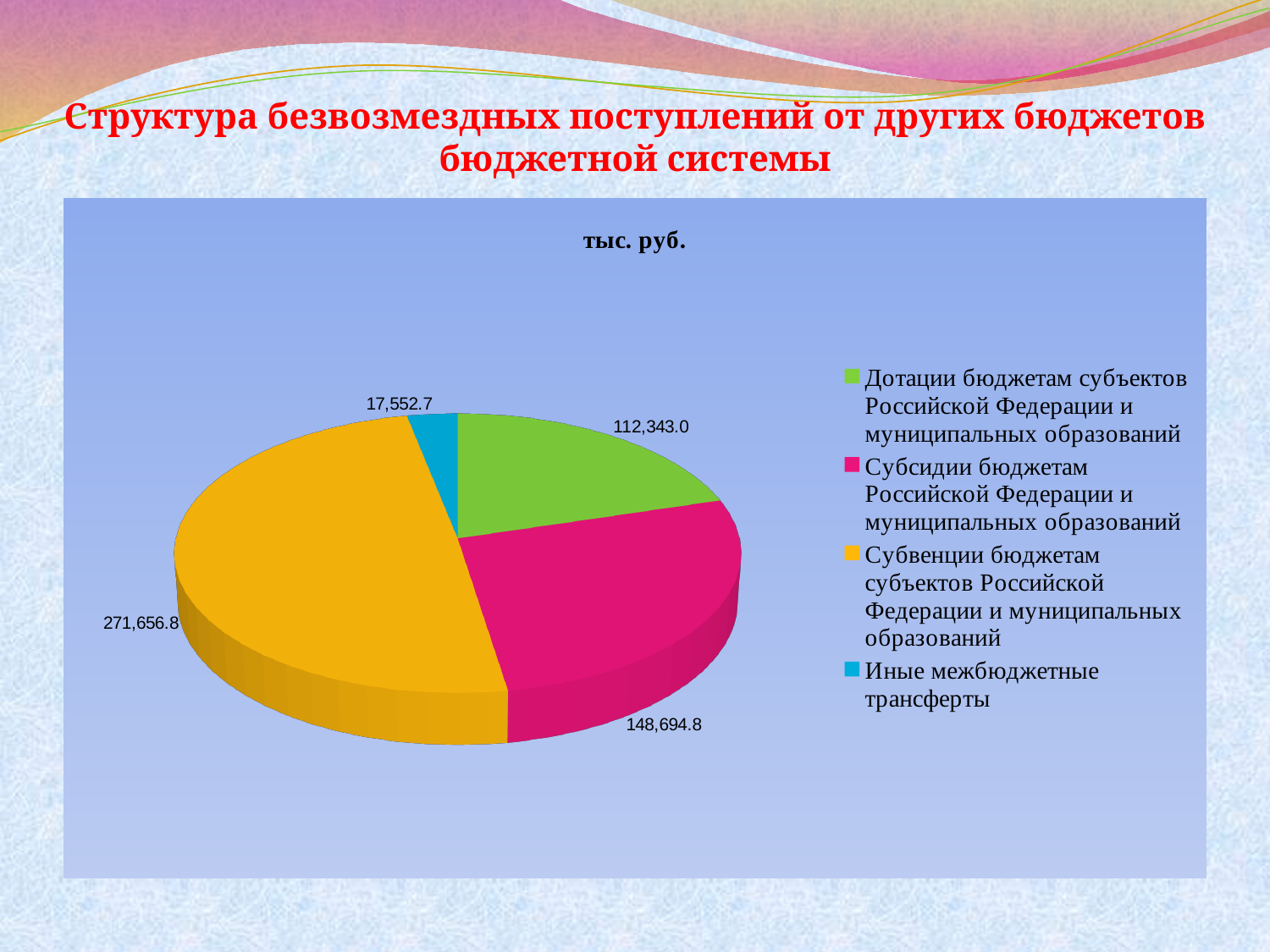
How many slices does the pie chart have? 4 Which category has the largest slice of the pie? Субвенции бюджетам субъектов Российской Федерации и муниципальных образований What is the difference between the values for Субсидии and Дотации? 36,351.8 Which category has the smallest slice of the pie? Иные межбюджетные трансферты What is the value for Иные межбюджетные трансферты? 17,552.7 What is the value for Дотации бюджетам субъектов Российской Федерации и муниципальных образований? 112,343.0 What unit is given in the chart title? тыс. руб. Which is larger, the value for Субсидии or the value for Дотации? Субсидии What is the value for Субсидии бюджетам Российской Федерации и муниципальных образований? 148,694.8 What kind of chart is shown on the slide? Pie chart What is the difference between the values for Субвенции and Субсидии? 122,962.0 What is the value for Субвенции бюджетам субъектов Российской Федерации и муниципальных образований? 271,656.8